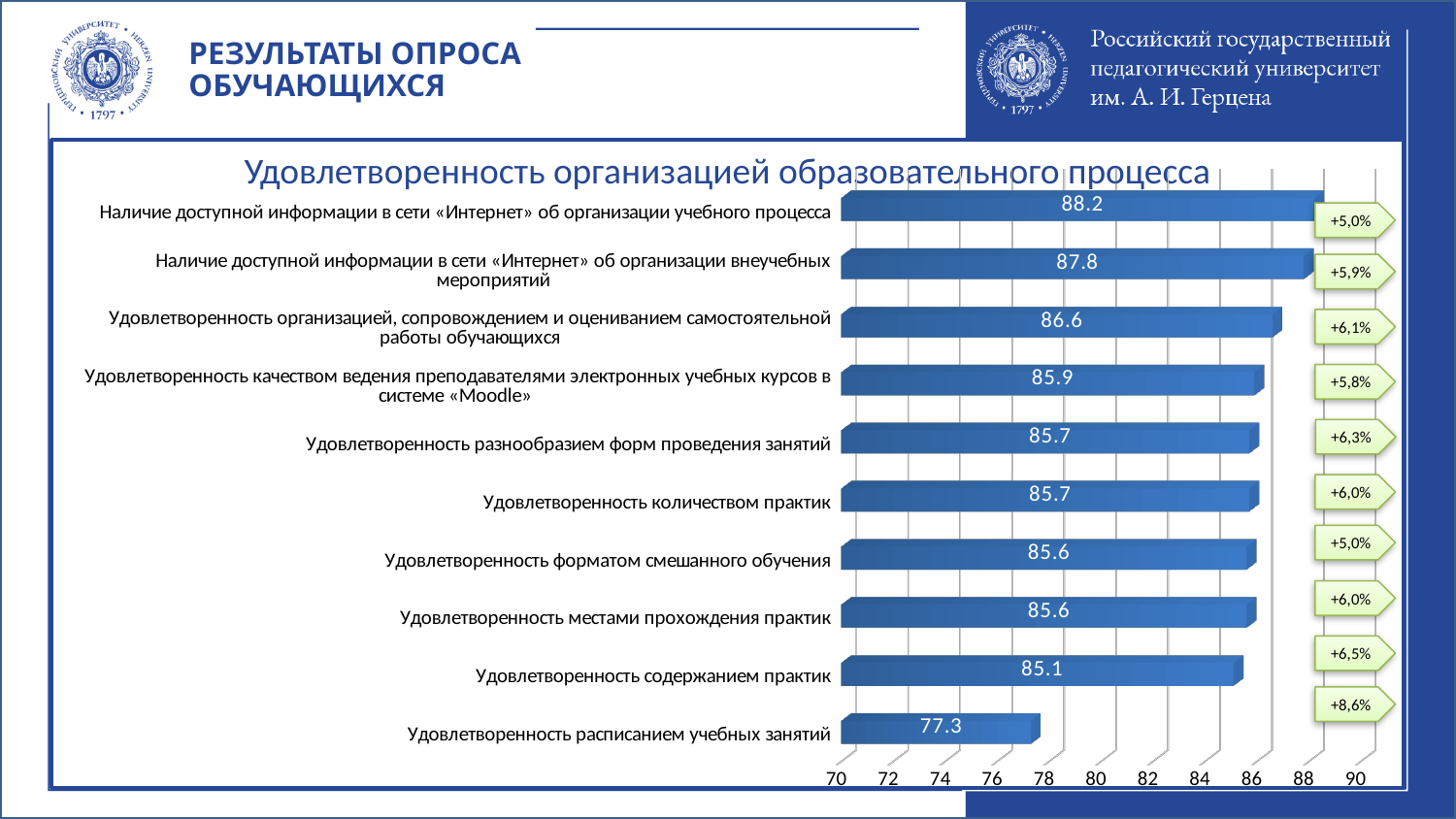
What is the value for «Удовлетворенность качеством ведения преподавателями электронных учебных курсов в системе «Moodle»»? 85.9 What is the difference between the values for «Наличие доступной информации в сети «Интернет» об организации внеучебных мероприятий» and «Удовлетворенность форматом смешанного обучения»? 2.2 Is the value for «Удовлетворенность расписанием учебных занятий» greater or less than 80? less What is the value for «Удовлетворенность расписанием учебных занятий»? 77.3 What is the value for «Удовлетворенность содержанием практик»? 85.1 What is the title of the chart? Удовлетворенность организацией образовательного процесса What type of chart is shown on the slide? Bar chart How many categories are plotted in the chart? 10 What is the difference between the values for «Наличие доступной информации в сети «Интернет» об организации учебного процесса» and «Удовлетворенность расписанием учебных занятий»? 10.9 Which category has the highest value? Наличие доступной информации в сети «Интернет» об организации учебного процесса Which category has the lowest value? Удовлетворенность расписанием учебных занятий Which is larger: the value for «Удовлетворенность организацией, сопровождением и оцениванием самостоятельной работы обучающихся» or for «Удовлетворенность содержанием практик»? Удовлетворенность организацией, сопровождением и оцениванием самостоятельной работы обучающихся